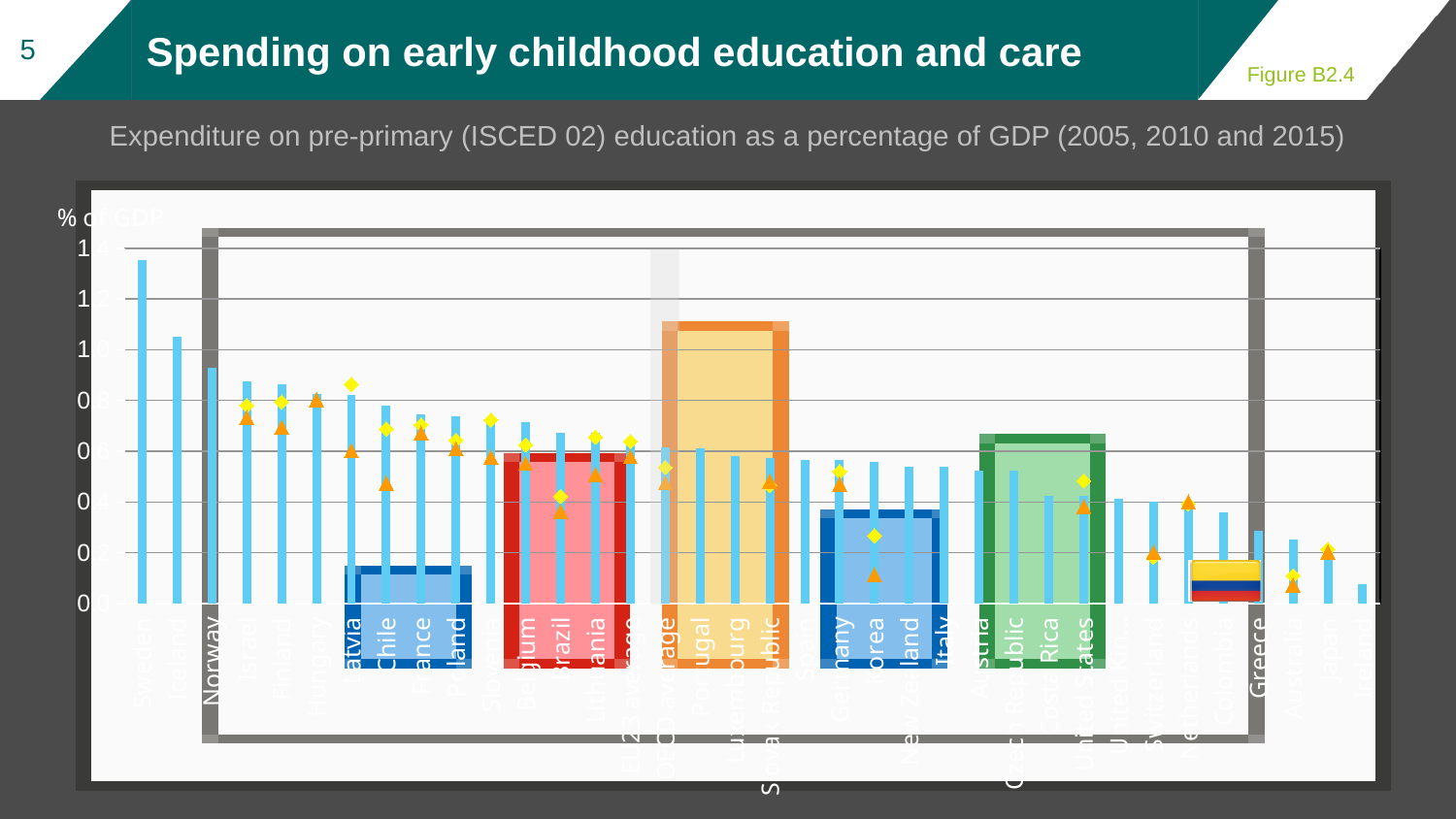
What kind of chart is shown on the slide? bar chart Is the value for Sweden greater or less than 1.2? greater Which country has the highest expenditure on pre-primary education as a percentage of GDP? Sweden Which country has the lowest expenditure on pre-primary education as a percentage of GDP? Ireland Is the value for Norway greater or less than 0.8? greater Which has a higher value, Sweden or Greece? Sweden Is the value for Switzerland greater or less than 0.6? less What is the label on the vertical axis of the chart? % of GDP Do the bar values generally rise or fall from left to right along the x axis? fall